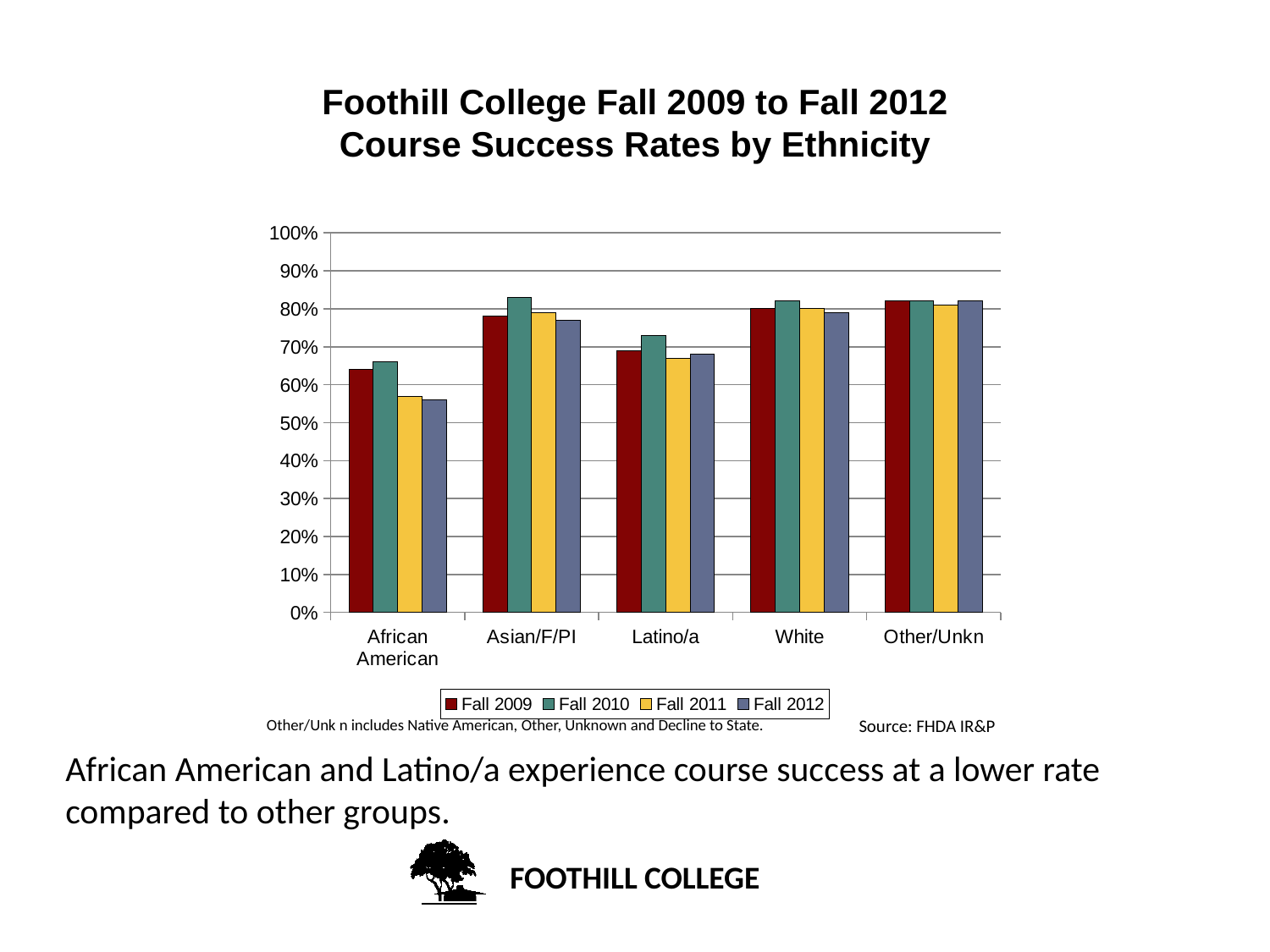
Which category has the lowest Fall 2011 course success rate? African American What kind of chart is shown on the slide? bar chart Which ethnicity category has the lowest course success rates overall? African American Is the Fall 2011 value for African American greater or less than 60%? less Which is larger, the Fall 2010 value for Asian/F/PI or the Fall 2010 value for Latino/a? Asian/F/PI What is the title of the chart? Foothill College Fall 2009 to Fall 2012 Course Success Rates by Ethnicity Is the Fall 2011 value for Latino/a greater or less than 70%? less How many series does the legend list? 4 Which is larger, the Fall 2012 value for African American or the Fall 2012 value for White? White How many ethnicity categories are shown on the x axis? 5 Is the Fall 2010 value for Asian/F/PI greater or less than 80%? greater